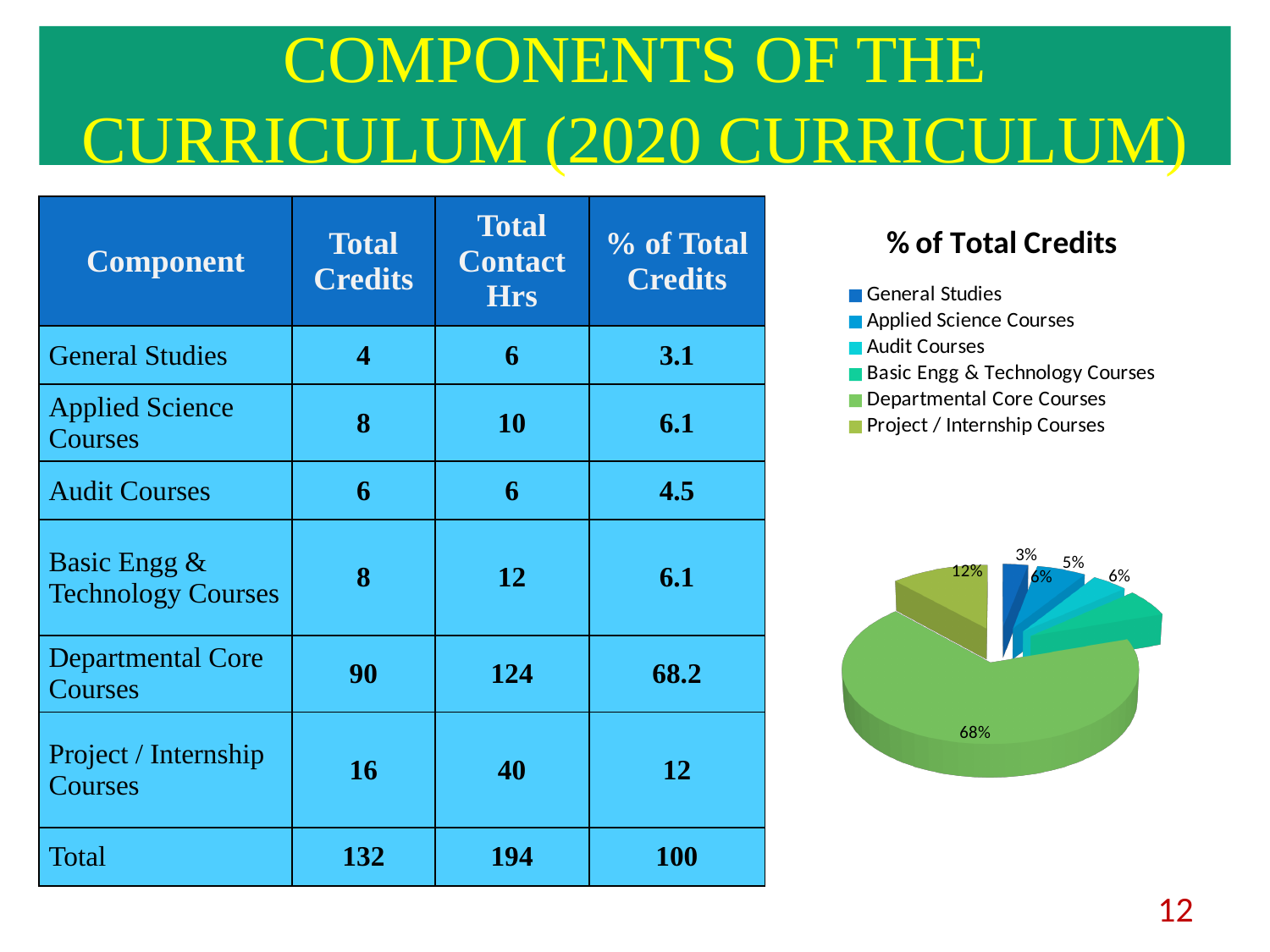
What kind of chart is shown on the slide? pie chart What is the title of the chart? % of Total Credits What is the difference in percentage points between the Departmental Core Courses slice and the Project / Internship Courses slice? 56 Which category has the largest slice in the pie chart? Departmental Core Courses What percentage does the pie chart show for Departmental Core Courses? 68% How many entries does the chart's legend list? 6 What percentage does the pie chart show for Audit Courses? 5% Which slice is larger in the pie chart: Project / Internship Courses or Audit Courses? Project / Internship Courses How many slices does the pie chart have? 6 What percentage does the pie chart show for General Studies? 3% Which category has the smallest slice in the pie chart? General Studies What percentage does the pie chart show for Project / Internship Courses? 12%